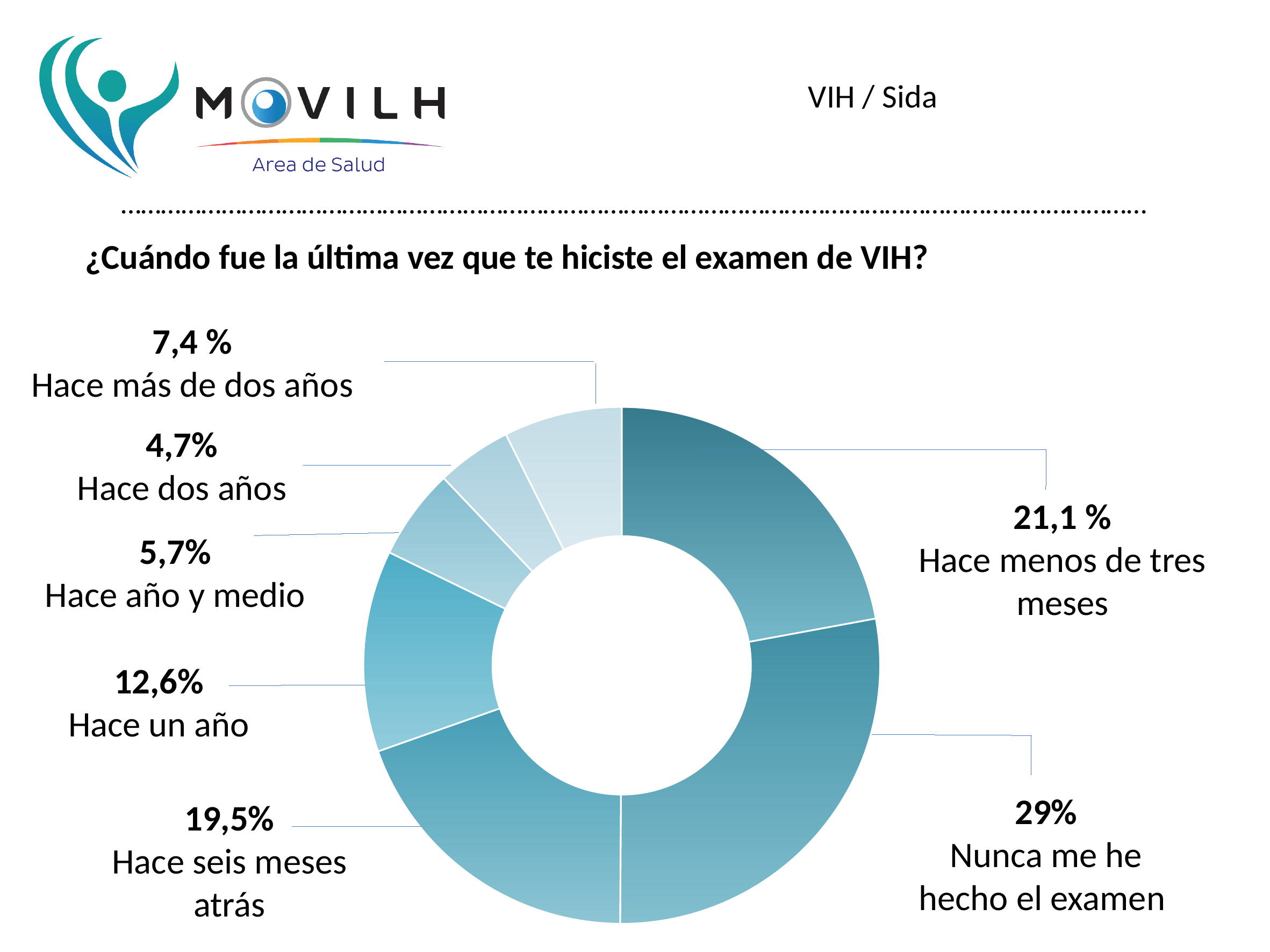
What is the value shown for "Hace un año"? 12,6% Which category has the smallest share of the chart? Hace dos años Which category has the largest share of the chart? Nunca me he hecho el examen Which is larger: "Hace más de dos años" or "Hace año y medio"? Hace más de dos años What percentage of respondents answered "Hace menos de tres meses"? 21,1 % What kind of chart is shown on the slide? Donut (pie) chart What percentage of respondents answered "Nunca me he hecho el examen"? 29% What is the value shown for "Hace dos años"? 4,7% How many categories are shown in the chart? 7 What question does the chart title ask? ¿Cuándo fue la última vez que te hiciste el examen de VIH? What is the value shown for "Hace seis meses atrás"? 19,5% How many percentage points higher is "Nunca me he hecho el examen" than "Hace menos de tres meses"? 7,9